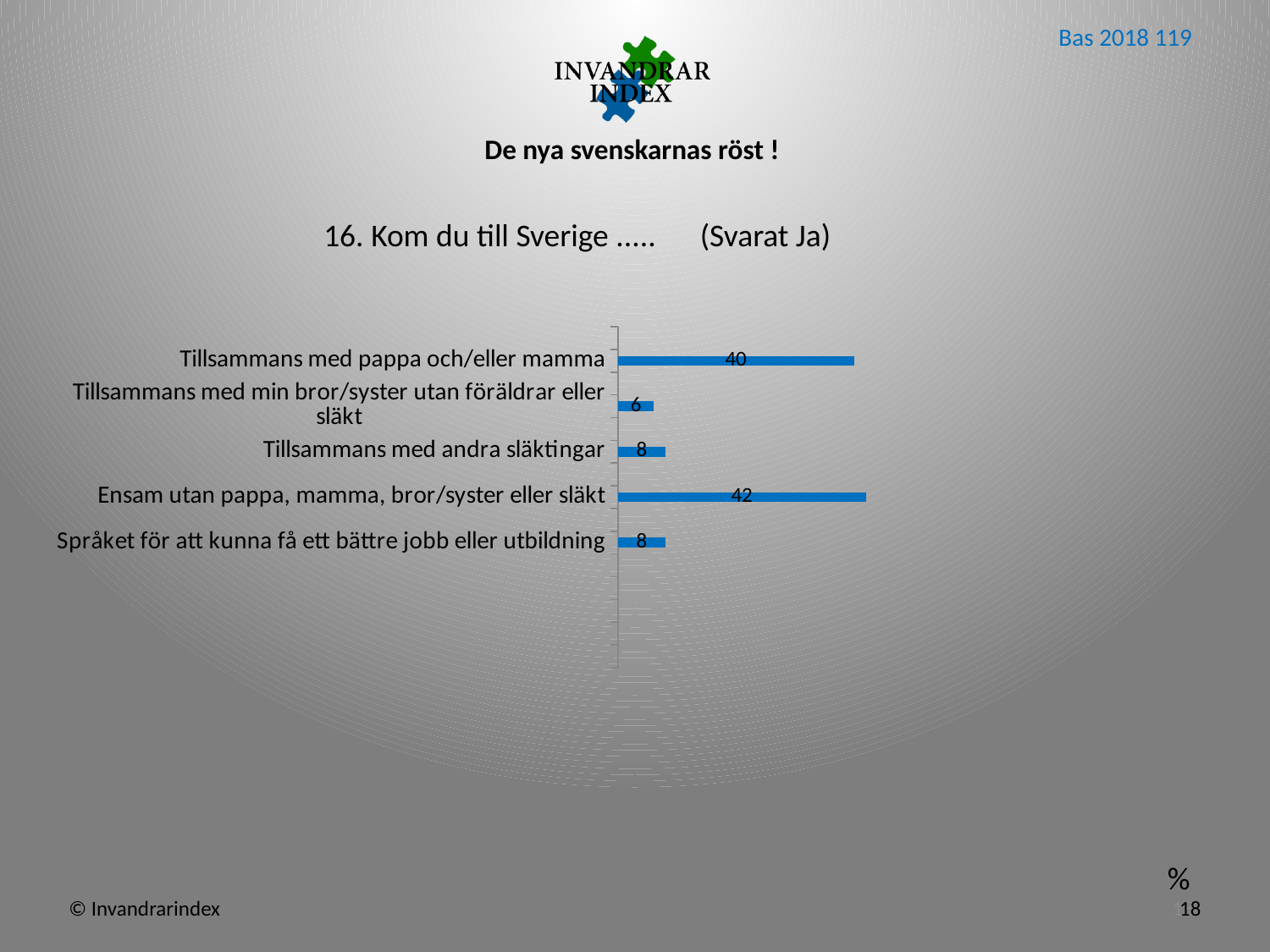
Which category has the lowest value? Tillsammans med min bror/syster utan föräldrar eller släkt What is the value for "Tillsammans med pappa och/eller mamma"? 40 What kind of chart is shown on the slide? Bar chart Which is larger: the value for "Tillsammans med andra släktingar" or the value for "Tillsammans med min bror/syster utan föräldrar eller släkt"? Tillsammans med andra släktingar What is the value for "Ensam utan pappa, mamma, bror/syster eller släkt"? 42 What is the difference between the values for "Ensam utan pappa, mamma, bror/syster eller släkt" and "Tillsammans med pappa och/eller mamma"? 2 Which category has the highest value? Ensam utan pappa, mamma, bror/syster eller släkt What is the value for "Tillsammans med andra släktingar"? 8 What is the title of the chart? 16. Kom du till Sverige ..... (Svarat Ja) What is the value for "Språket för att kunna få ett bättre jobb eller utbildning"? 8 How many categories are shown in the chart? 5 What is the value for "Tillsammans med min bror/syster utan föräldrar eller släkt"? 6